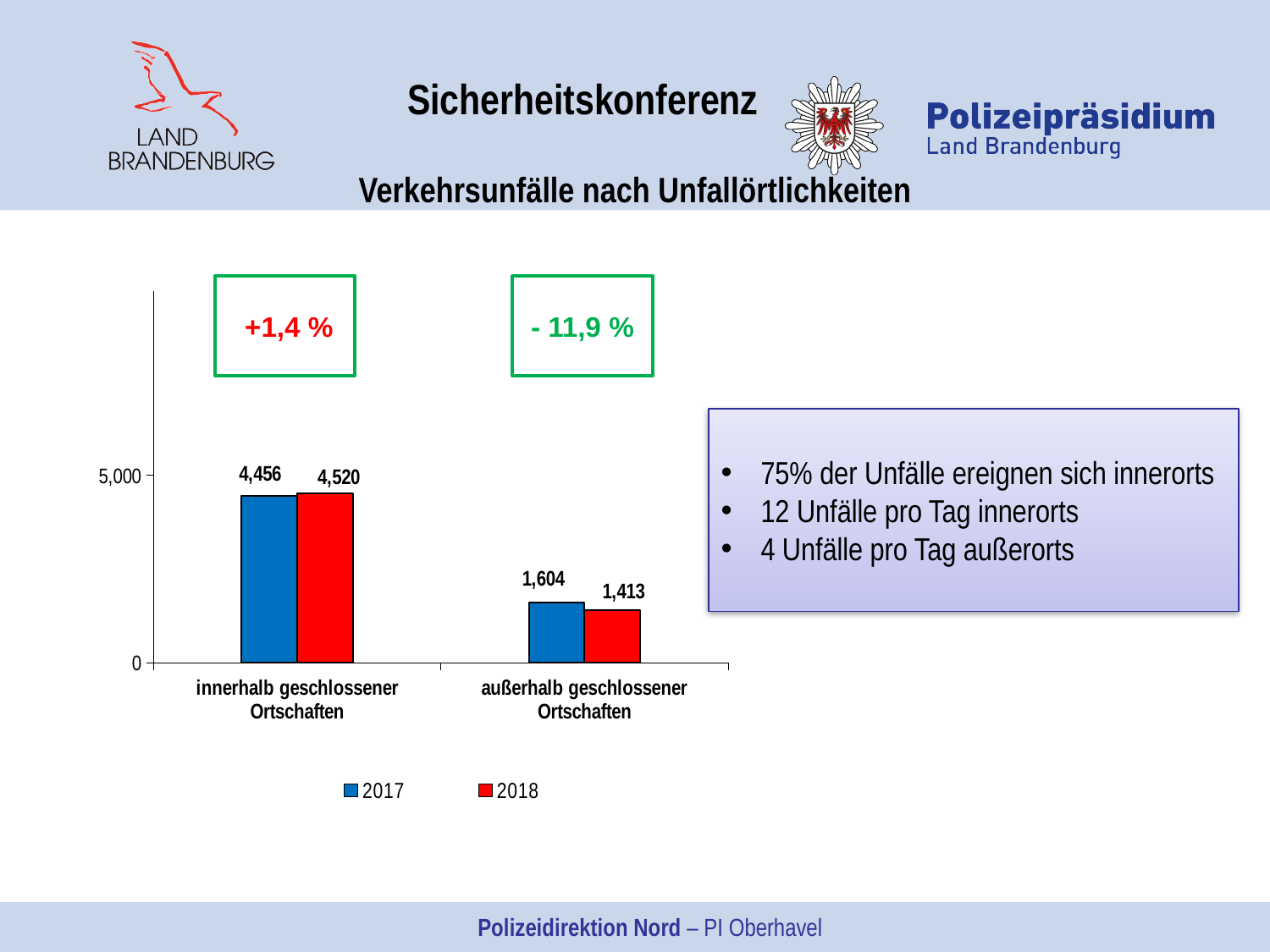
Which is larger for 'außerhalb geschlossener Ortschaften': the 2017 value or the 2018 value? 2017 Which category has the lowest value for 2017? außerhalb geschlossener Ortschaften Which category has the highest value for 2018? innerhalb geschlossener Ortschaften How many series does the legend list? 2 How many categories are shown on the x axis? 2 What is the difference between the 2017 and 2018 values for 'außerhalb geschlossener Ortschaften'? 191 What is the difference between the 2018 and 2017 values for 'innerhalb geschlossener Ortschaften'? 64 What kind of chart is shown on the slide? bar chart Is the 2017 value for 'außerhalb geschlossener Ortschaften' greater or less than 5,000? less What is the value for 2017 in the category 'innerhalb geschlossener Ortschaften'? 4,456 What is the value for 2018 in the category 'innerhalb geschlossener Ortschaften'? 4,520 What is the value for 2018 in the category 'außerhalb geschlossener Ortschaften'? 1,413